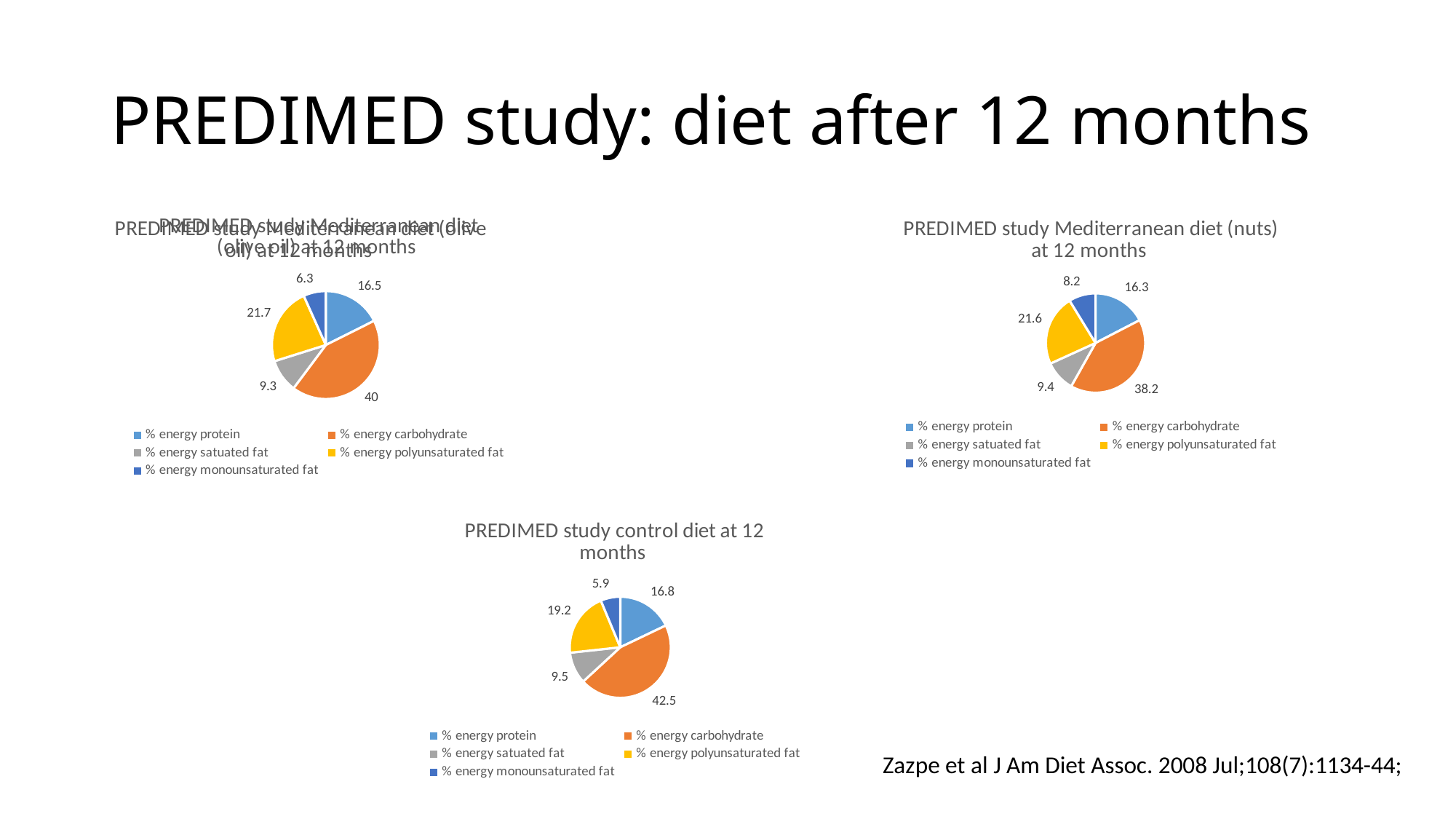
In the PREDIMED study control diet at 12 months chart, which category has the smallest slice? % energy monounsaturated fat In the PREDIMED study control diet at 12 months chart, what colour is the % energy carbohydrate slice? Orange Which is larger: % energy polyunsaturated fat in the Mediterranean diet (nuts) chart or % energy polyunsaturated fat in the control diet chart? Mediterranean diet (nuts) In the PREDIMED study control diet at 12 months chart, what is the value for % energy carbohydrate? 42.5 How many slices does the PREDIMED study control diet at 12 months pie chart have? 5 In the PREDIMED study Mediterranean diet (olive oil) at 12 months chart, which category has the largest slice? % energy carbohydrate What is the difference between the % energy carbohydrate value in the control diet chart and the % energy carbohydrate value in the Mediterranean diet (olive oil) chart? 2.5 In the PREDIMED study Mediterranean diet (nuts) at 12 months chart, what is the value for % energy monounsaturated fat? 8.2 What kind of chart is the PREDIMED study Mediterranean diet (nuts) at 12 months chart? Pie chart In the PREDIMED study Mediterranean diet (olive oil) at 12 months chart, what is the value for % energy polyunsaturated fat? 21.7 How many pie charts are shown on the slide? 3 In the PREDIMED study Mediterranean diet (nuts) at 12 months chart, what is the value for % energy protein? 16.3